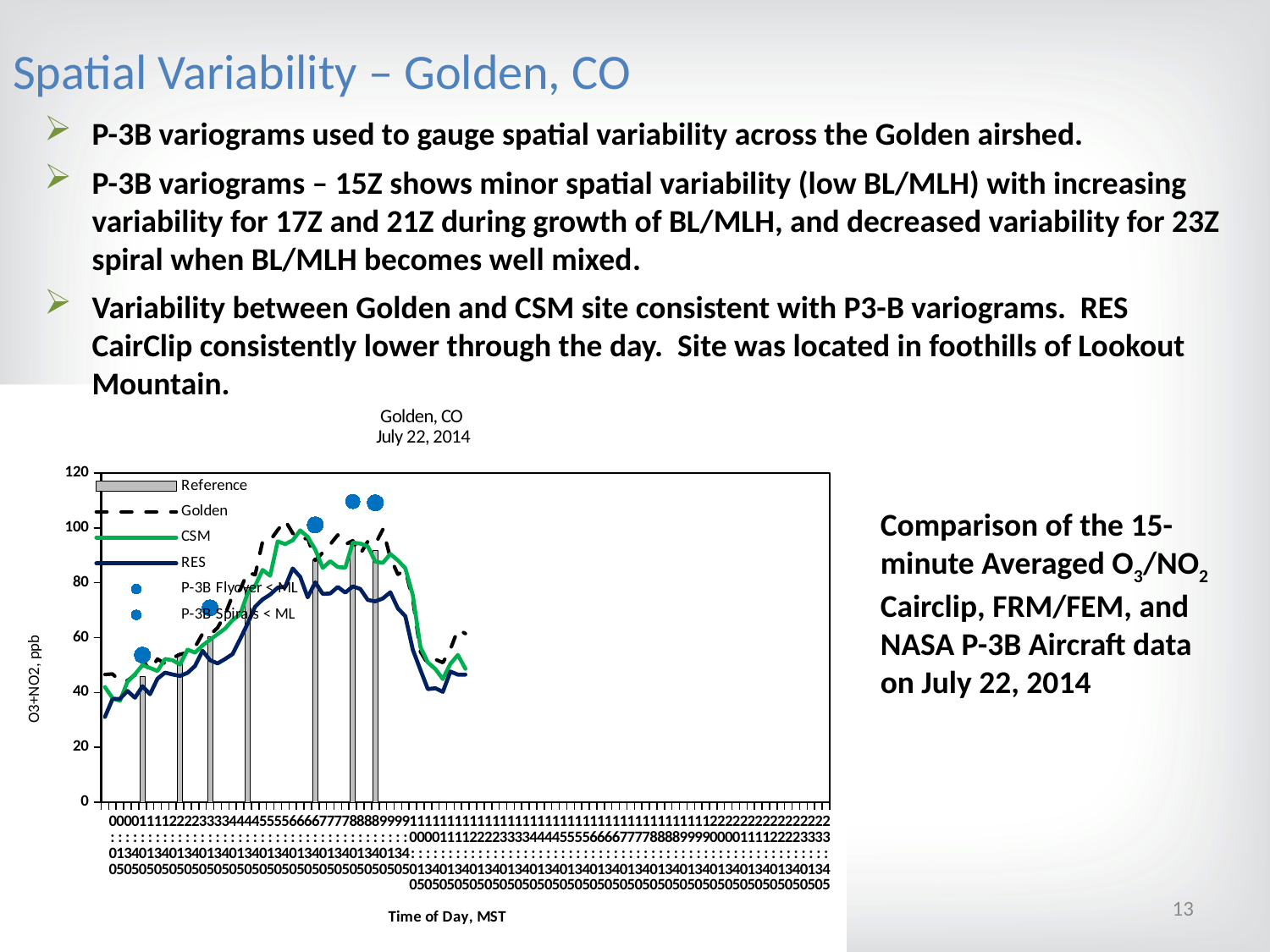
Is the peak value of the CSM line greater or less than 80? greater What is the title of the chart? Golden, CO July 22, 2014 Is the peak value of the Golden dashed line greater or less than 60? greater What kind of chart is shown on the slide? A combination chart with lines, bars and scatter points Which series is plotted as bars? Reference What is the highest tick value shown on the chart's vertical axis? 120 Is the lowest value of the RES line, at the left edge of the chart, greater or less than 40? less Which series is plotted as a dashed line? Golden What is the label of the chart's vertical axis? O3+NO2, ppb How many line series (Golden, CSM, RES) are plotted on the chart? 3 How many series does the chart legend list? 6